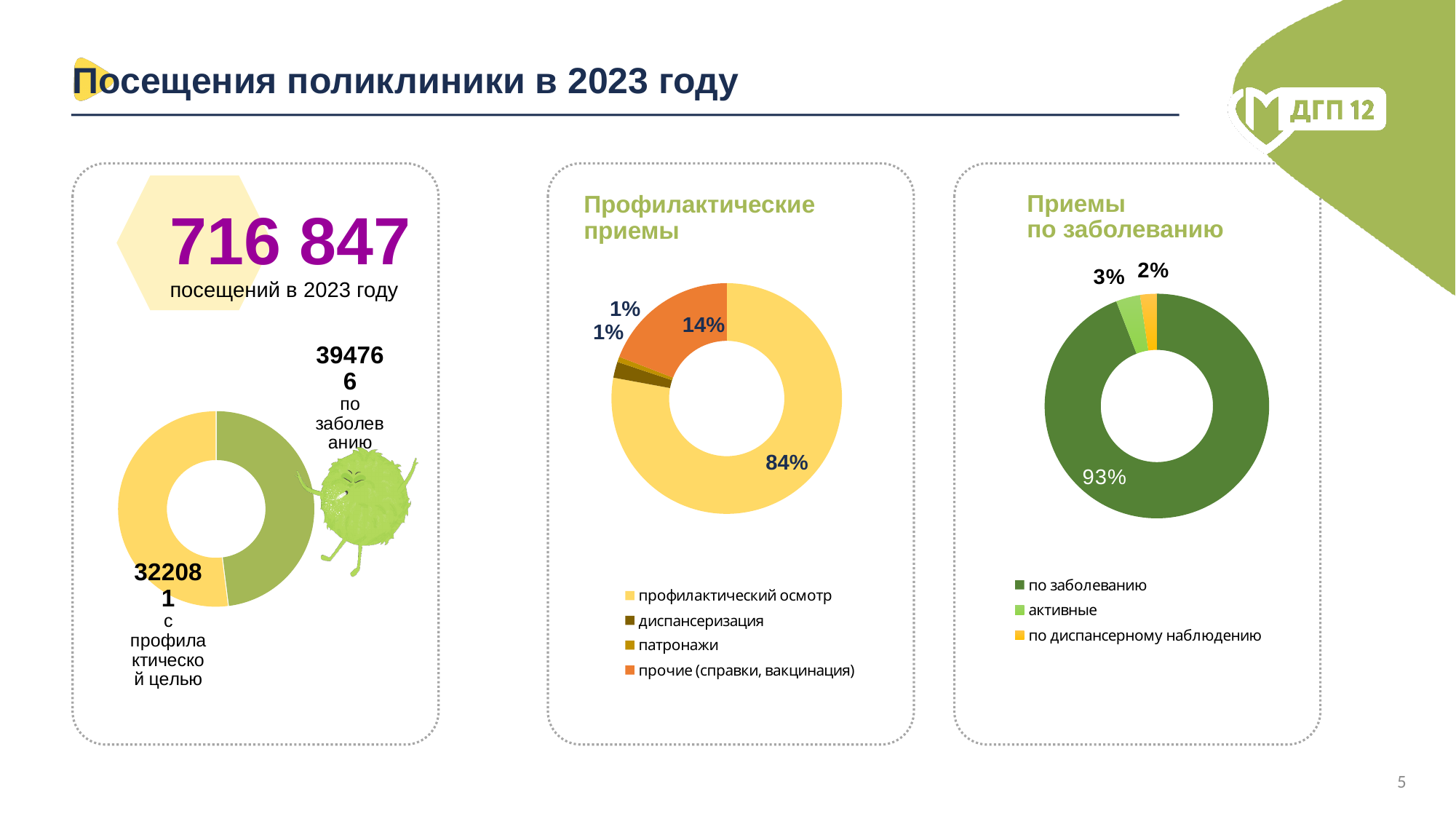
In the 'Приемы по заболеванию' chart, which is larger: 'активные' or 'по диспансерному наблюдению'? активные In the 'Профилактические приемы' chart, what share is 'прочие (справки, вакцинация)'? 14% In the 'Профилактические приемы' chart, what share is 'профилактический осмотр'? 84% In the 'Приемы по заболеванию' chart, what share is 'по заболеванию'? 93% In the left donut chart, which is larger: 'по заболеванию' or 'с профилактической целью'? по заболеванию In the 'Приемы по заболеванию' chart, what share is 'активные'? 3% In the 'Профилактические приемы' chart, which category has the largest share? профилактический осмотр In the left donut chart, what is the value for 'по заболеванию'? 394766 In the 'Профилактические приемы' chart, what is the difference between the shares of 'профилактический осмотр' and 'прочие (справки, вакцинация)'? 70% What kind of chart is used in the 'Профилактические приемы' panel? Donut (pie) chart In the 'Приемы по заболеванию' chart, which category has the smallest share? по диспансерному наблюдению How many entries does the legend of the 'Профилактические приемы' chart list? 4